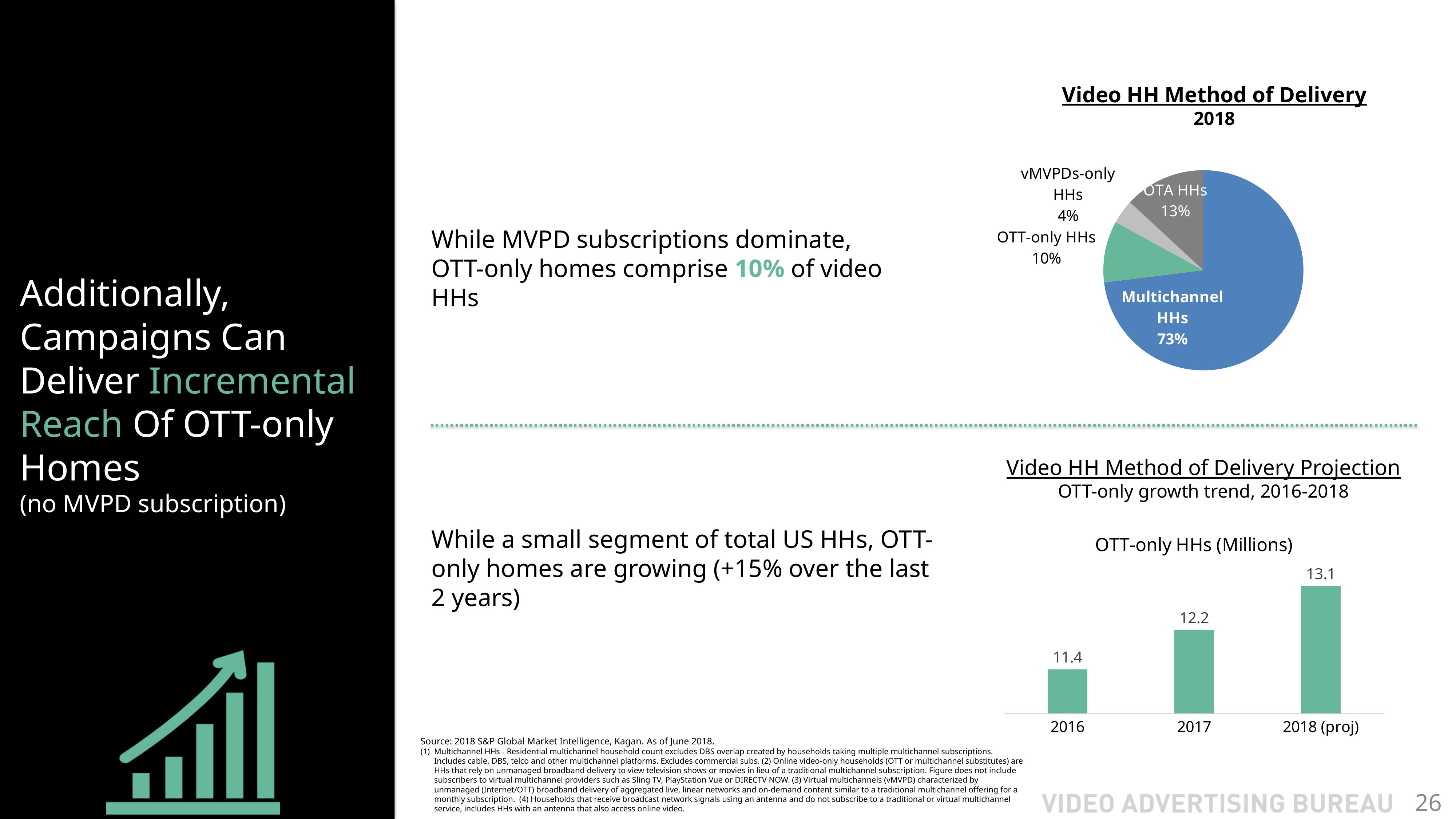
In the 'Video HH Method of Delivery Projection' bar chart, what is the value for 2017? 12.2 In the 'Video HH Method of Delivery Projection' bar chart, what is the difference between the 2018 (proj) value and the 2016 value? 1.7 In the 'Video HH Method of Delivery' pie chart, what share do vMVPDs-only HHs have? 4% In the 'Video HH Method of Delivery Projection' bar chart, do the values rise or fall from 2016 to 2018 (proj)? Rise In the 'Video HH Method of Delivery' pie chart, which category has the smallest slice? vMVPDs-only HHs In the 'Video HH Method of Delivery Projection' bar chart, what is the value for 2018 (proj)? 13.1 In the 'Video HH Method of Delivery' pie chart, what share do OTT-only HHs have? 10% In the 'Video HH Method of Delivery' pie chart, what share do Multichannel HHs have? 73% In the 'Video HH Method of Delivery' pie chart, what is the difference between the OTA HHs share and the OTT-only HHs share? 3% What kind of chart is the 'Video HH Method of Delivery Projection' chart? Bar chart In the 'Video HH Method of Delivery' pie chart, which category has the largest slice? Multichannel HHs In the 'Video HH Method of Delivery' pie chart, how many slices are there? 4